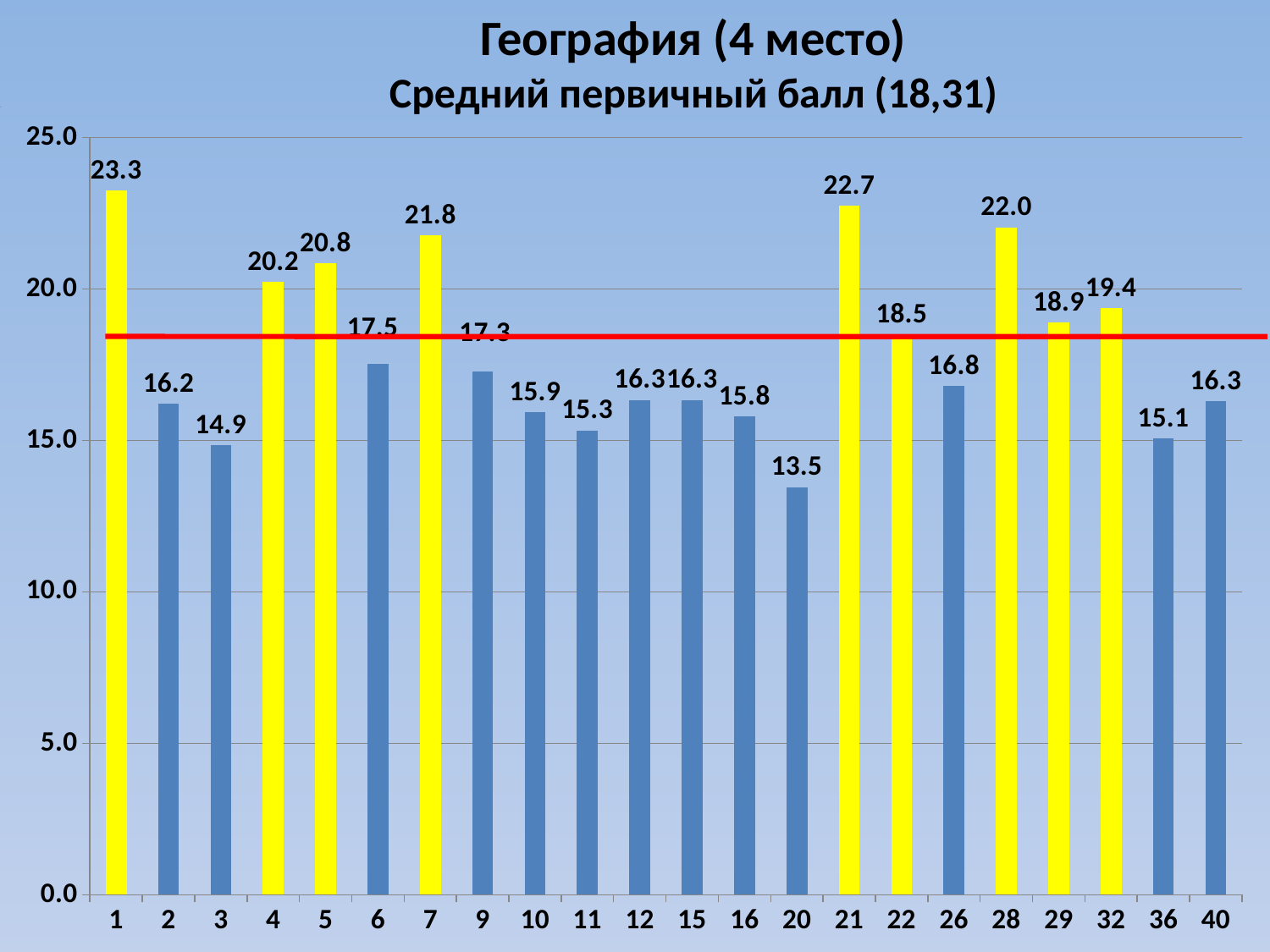
What is the value for category 32? 19.4 What is the value for category 1? 23.3 How many categories are shown on the x axis? 22 Which category has the highest value? 1 What is the difference between the values for category 21 and category 22? 4.2 Is the value for category 3 greater or less than 15.0? less Which is larger, the value for category 7 or the value for category 28? category 28 What kind of chart is shown on the slide? bar chart What is the value for category 28? 22.0 What is the value for category 20? 13.5 Which category has the lowest value? 20 What is the title of the chart? География (4 место) Средний первичный балл (18,31)